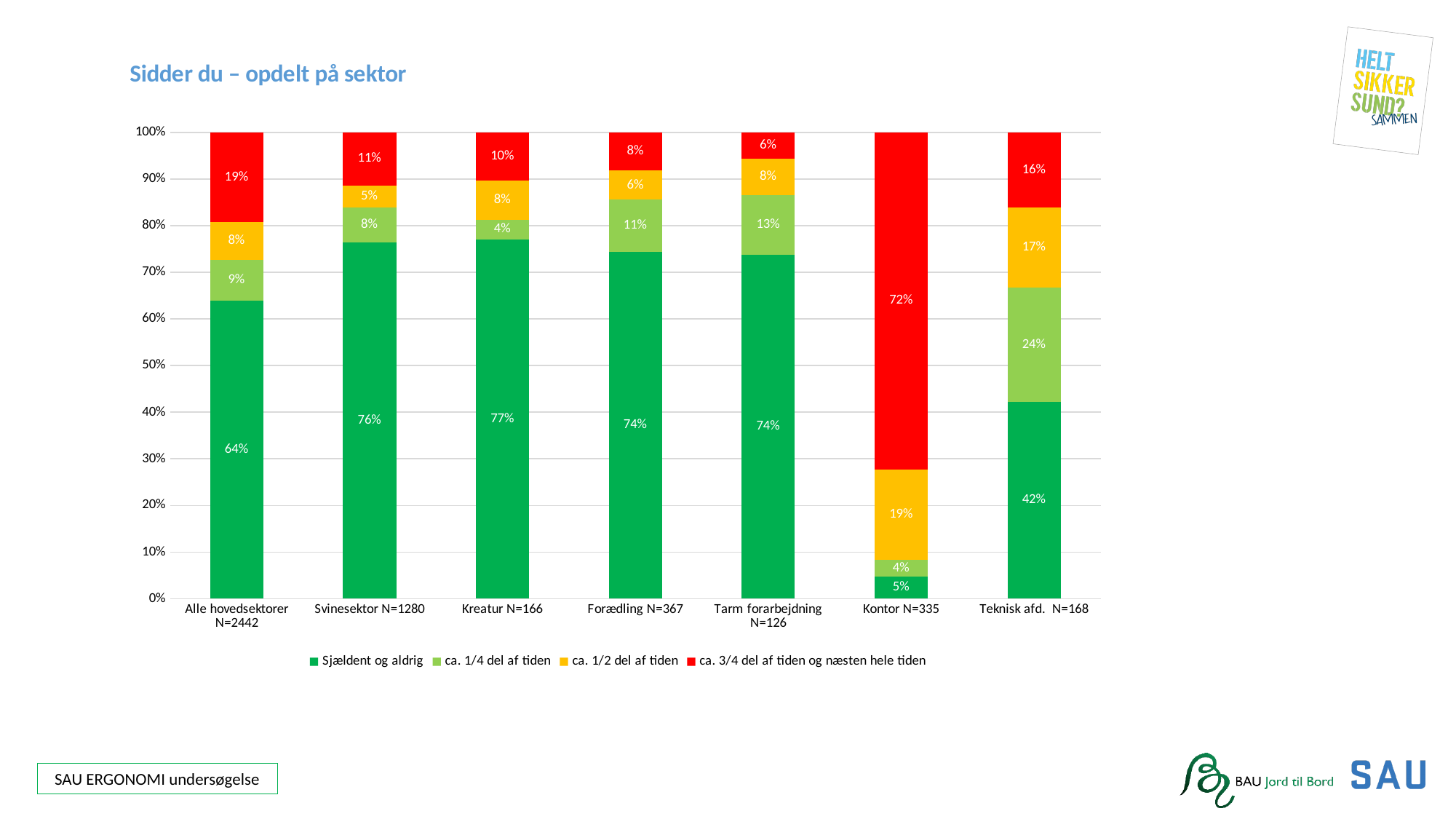
Which category has the highest value for 'Sjældent og aldrig'? Kreatur N=166 Which category has the lowest value for 'ca. 3/4 del af tiden og næsten hele tiden'? Tarm forarbejdning N=126 Which is larger: the 'ca. 1/4 del af tiden' value for Forædling N=367 or for Kreatur N=166? Forædling N=367 What is the difference between the 'ca. 3/4 del af tiden og næsten hele tiden' values for Kontor N=335 and Teknisk afd. N=168? 56% What is the value for 'Sjældent og aldrig' in the Kontor N=335 category? 5% What is the value for 'ca. 1/2 del af tiden' in the Tarm forarbejdning N=126 category? 8% How many series does the legend list? 4 How many categories are shown on the x axis? 7 What is the title of the chart? Sidder du – opdelt på sektor What is the value for 'ca. 1/4 del af tiden' in the Teknisk afd. N=168 category? 24% What is the value for 'ca. 3/4 del af tiden og næsten hele tiden' in the Alle hovedsektorer N=2442 category? 19% What kind of chart is shown on the slide? Stacked bar chart